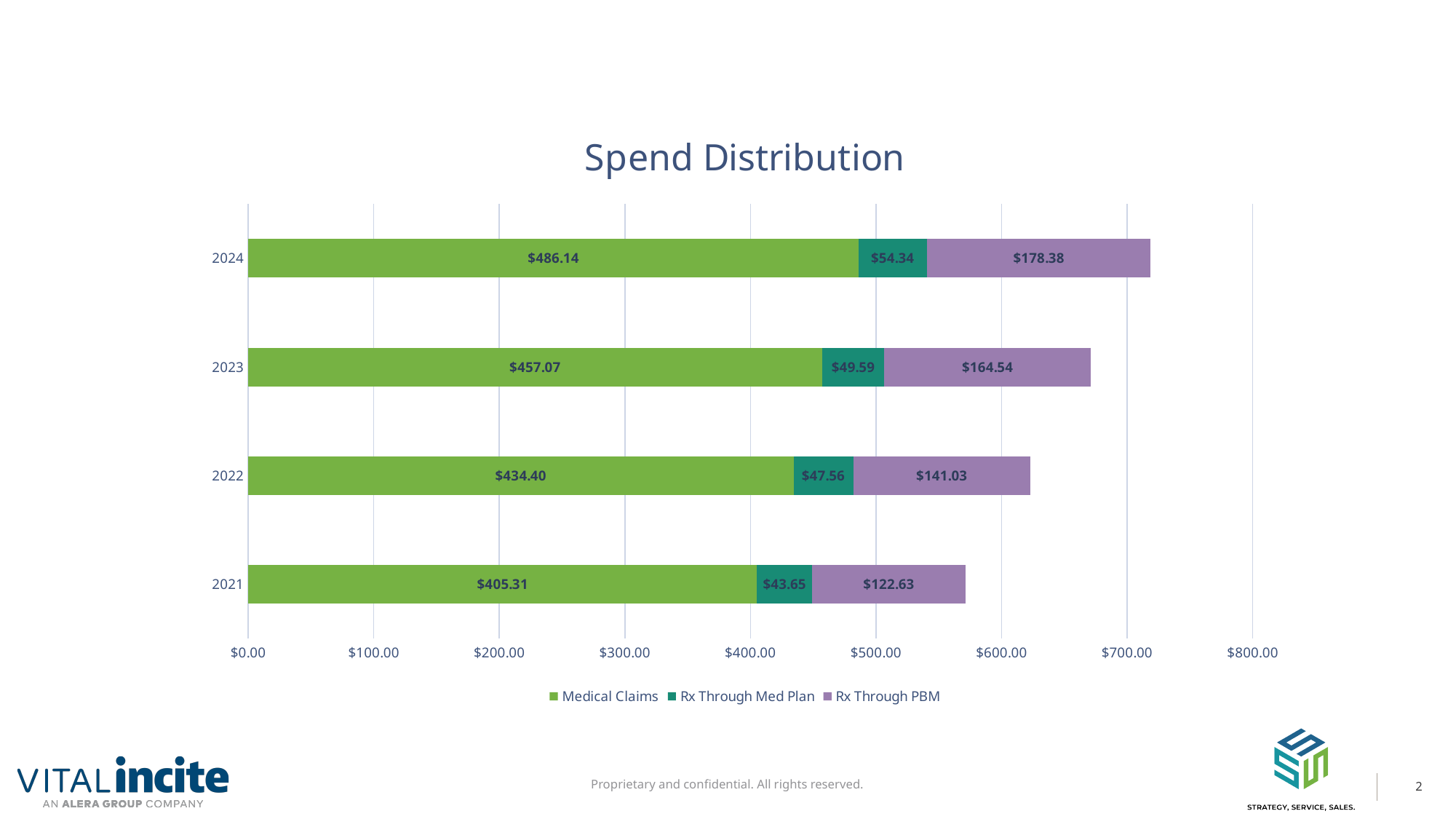
What is the total of the stacked bar for 2021? $571.59 What is the Medical Claims value for 2024? $486.14 Which is larger, the Rx Through PBM value for 2022 or for 2023? 2023 What is the Rx Through Med Plan value for 2023? $49.59 Which year has the highest Medical Claims value? 2024 Which year has the lowest Rx Through PBM value? 2021 How many series does the legend list? 3 What kind of chart is shown on the slide? Stacked bar chart What is the total of the stacked bar for 2024? $718.86 How many years are shown on the chart? 4 What is the Rx Through PBM value for 2021? $122.63 What is the difference between the Medical Claims values for 2024 and 2021? $80.83